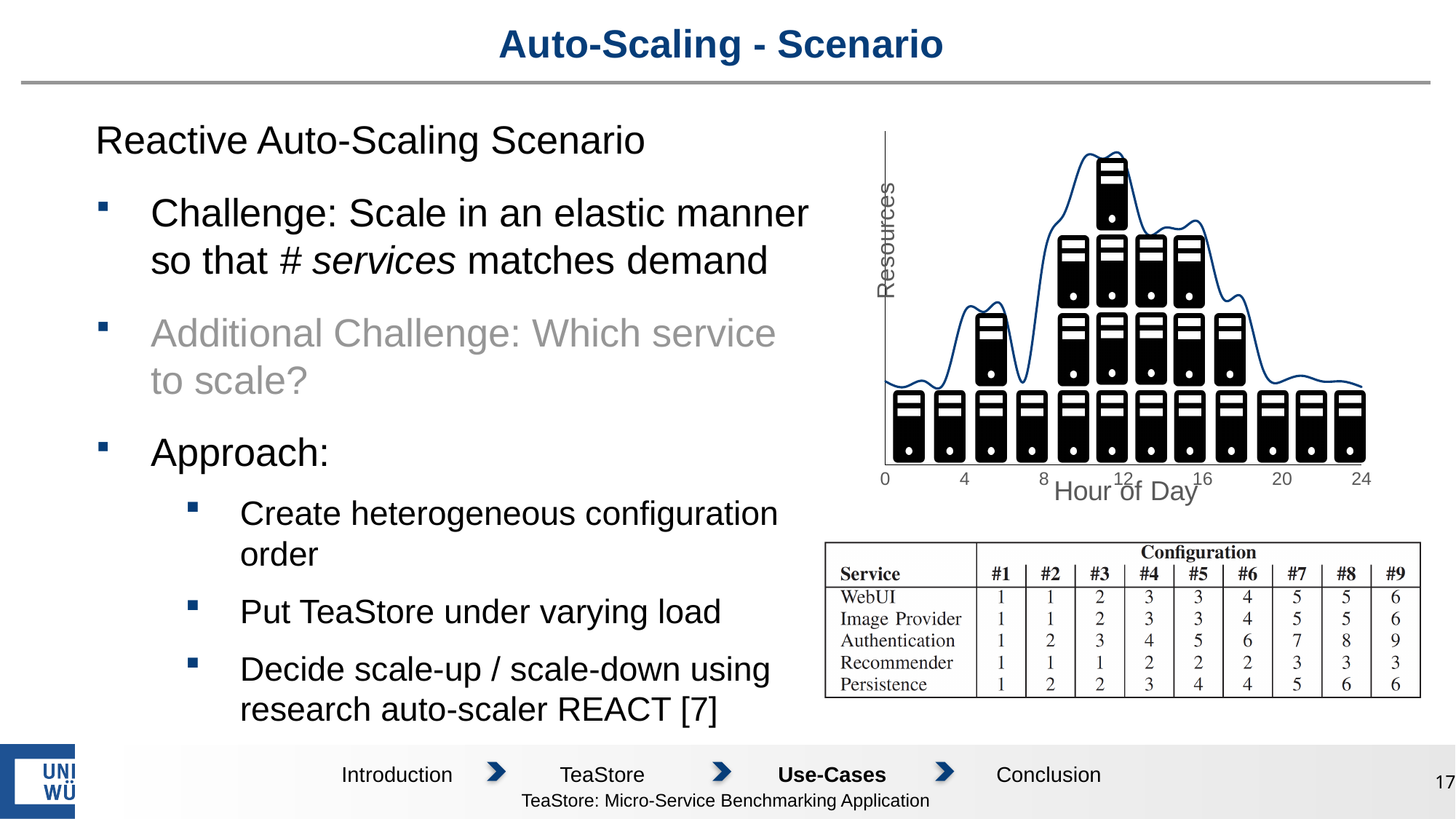
What is the maximum number of server icons stacked in a single column of the chart? 4 What is the label of the y axis of the chart? Resources What is the largest tick value shown on the x axis of the chart? 24 What kind of chart is shown on the right of the slide? line chart How many server icons are stacked in the column just before hour 12 (the tallest column)? 4 How many columns of server icons are drawn along the x axis of the chart? 12 What is the smallest tick value shown on the x axis of the chart? 0 Is the resource curve higher at hour 12 or at hour 22? hour 12 Does the resource curve rise or fall between hour 8 and hour 12? rise How many tick labels are shown on the x axis of the chart? 7 Does the resource curve rise or fall between hour 16 and hour 20? fall What is the label of the x axis of the chart? Hour of Day